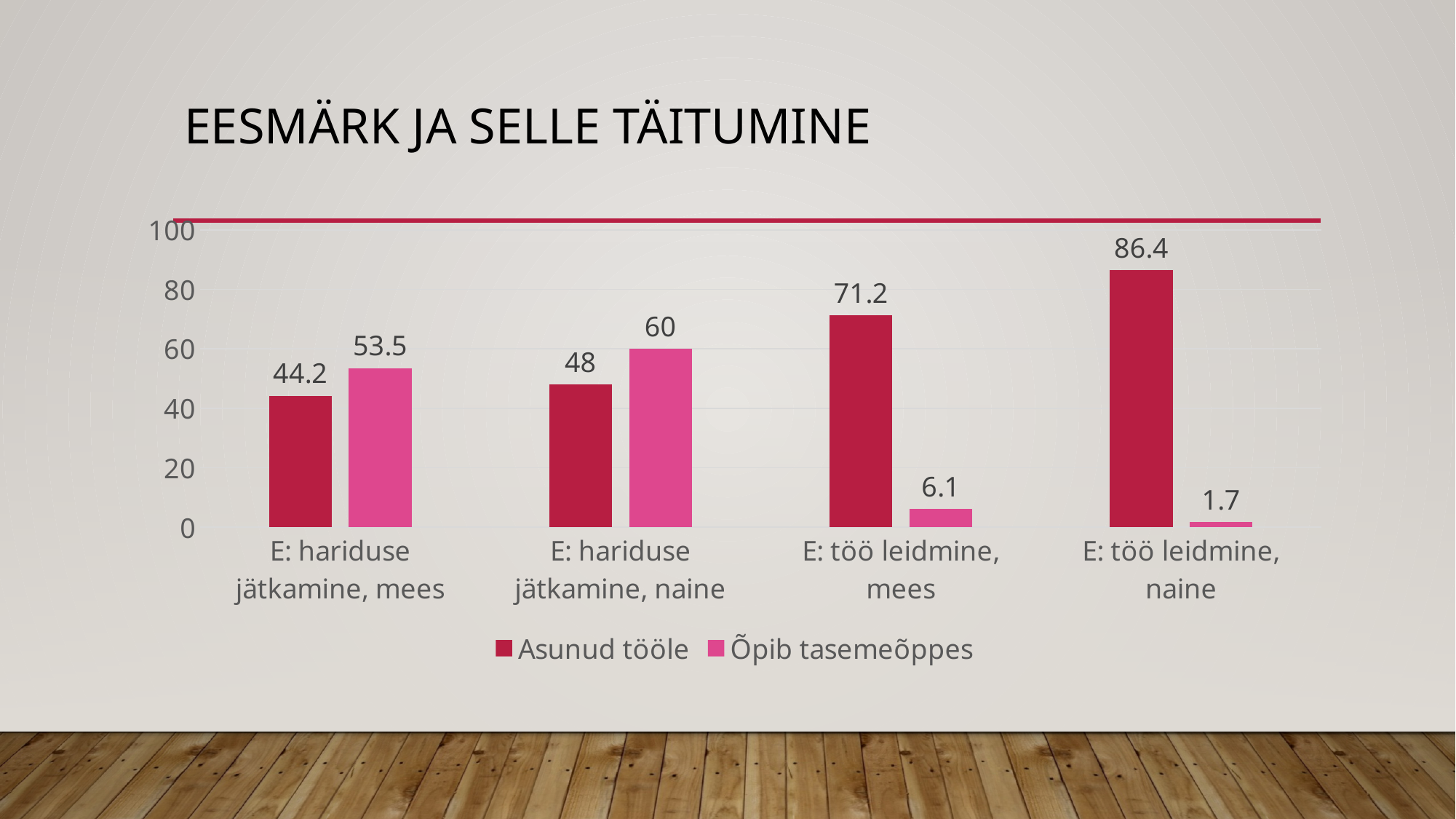
What kind of chart is shown on the slide? bar chart How many categories are shown on the x axis? 4 How many series does the legend list? 2 Which category has the lowest 'Õpib tasemeõppes' value? E: töö leidmine, naine For 'E: hariduse jätkamine, naine', which is larger: 'Asunud tööle' or 'Õpib tasemeõppes'? Õpib tasemeõppes Which category has the highest 'Asunud tööle' value? E: töö leidmine, naine What is the value of 'Õpib tasemeõppes' for 'E: hariduse jätkamine, naine'? 60 What is the title of the slide? EESMÄRK JA SELLE TÄITUMINE What is the value of 'Õpib tasemeõppes' for 'E: töö leidmine, naine'? 1.7 Is the 'Asunud tööle' value for 'E: töö leidmine, naine' greater or less than 80? greater What is the value of 'Asunud tööle' for 'E: hariduse jätkamine, mees'? 44.2 What is the difference between 'Asunud tööle' and 'Õpib tasemeõppes' for 'E: töö leidmine, mees'? 65.1